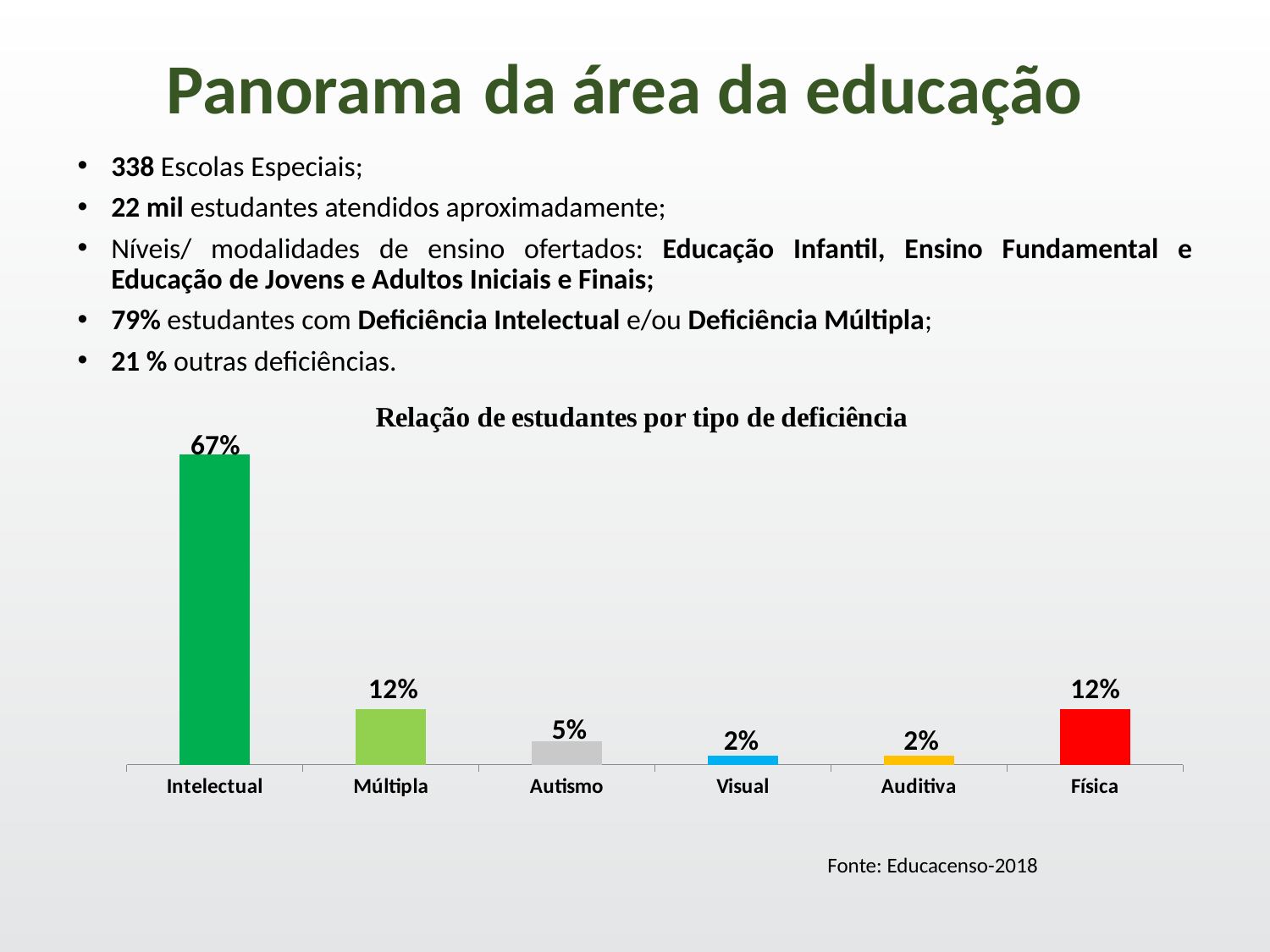
What is the difference between the values for Autismo and Visual? 3% How many categories are shown on the x axis? 6 What is the difference between the values for Intelectual and Múltipla? 55% What colour is the bar for Física? Red What is the value for Intelectual? 67% Which category has the highest value? Intelectual What is the value for Física? 12% What is the title of the chart? Relação de estudantes por tipo de deficiência Which is larger, the value for Múltipla or the value for Autismo? Múltipla Which is larger, the value for Física or the value for Auditiva? Física What kind of chart is shown on the slide? Bar chart What is the value for Autismo? 5%